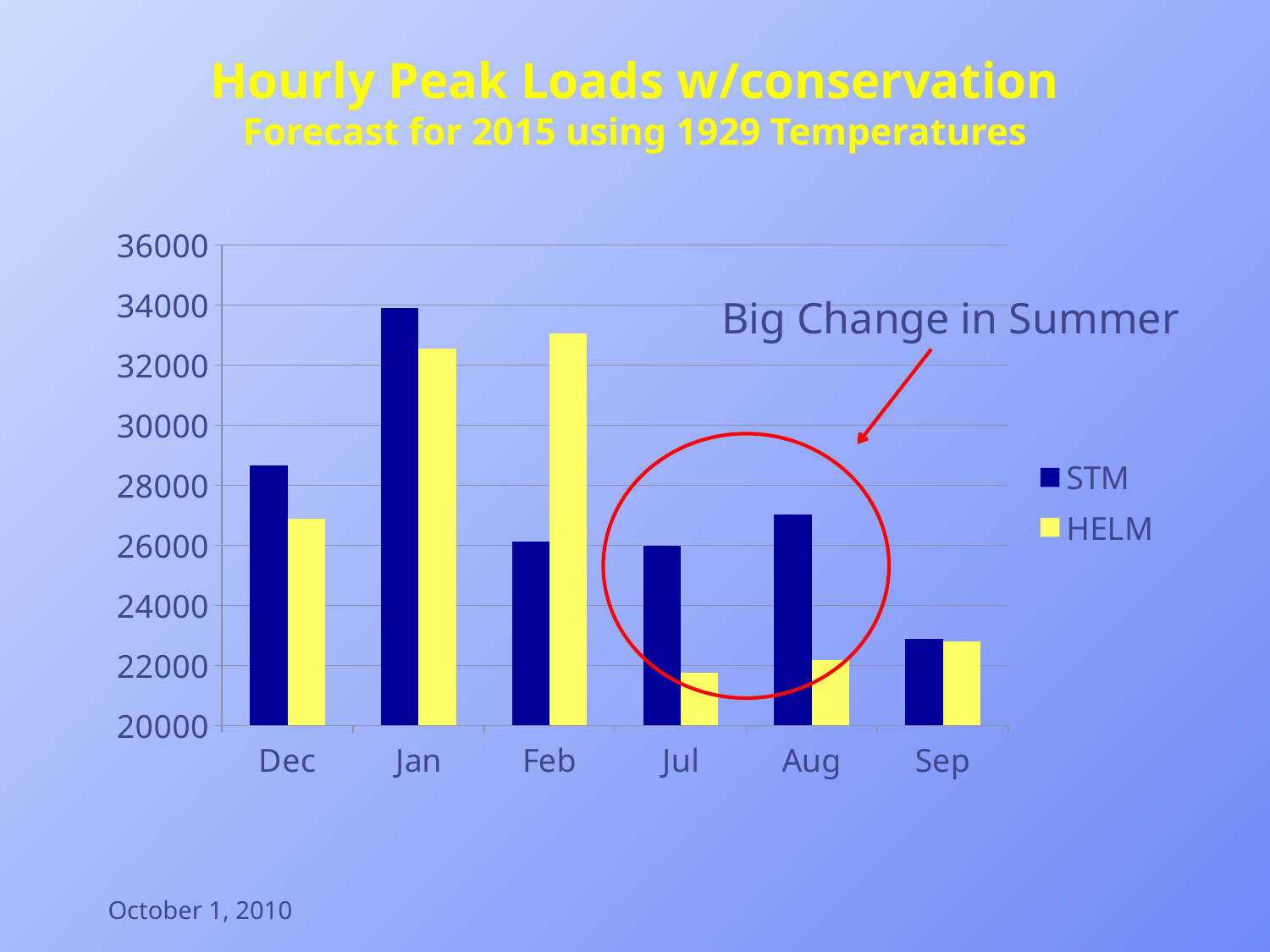
Which month has the highest STM value? Jan What are the two series named in the legend? STM and HELM Which month has the lowest STM value? Sep How many months are shown on the x axis? 6 How many series does the legend list? 2 Which month has the highest HELM value? Feb In Feb, which series has the larger value, STM or HELM? HELM Which month has the lowest HELM value? Jul Is the STM value for Jan greater or less than 32000? greater In Jul, which series has the larger value, STM or HELM? STM Is the HELM value for Aug greater or less than 24000? less What kind of chart is shown on the slide? bar chart